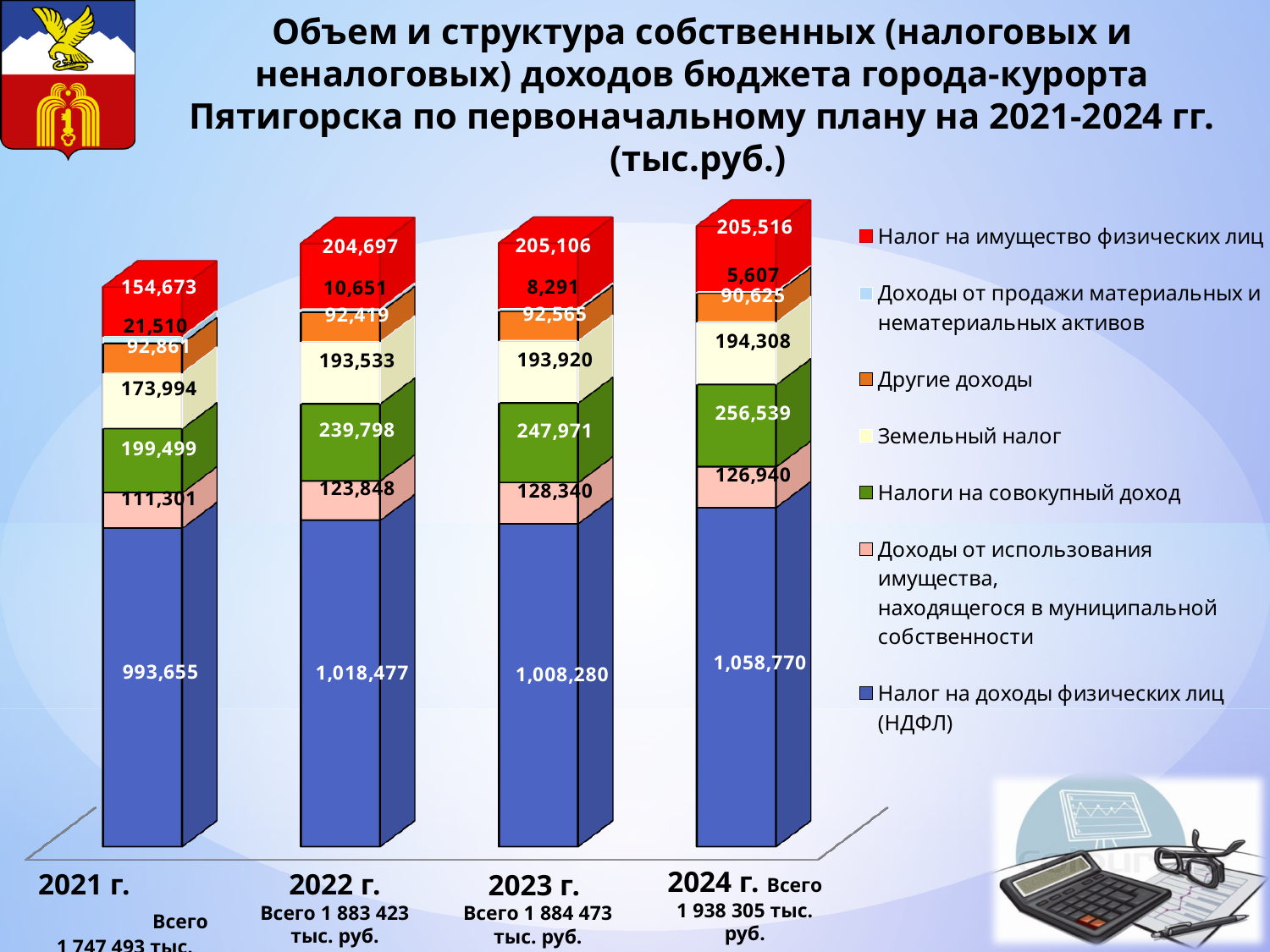
Which year has the larger value for Налоги на совокупный доход, 2022 г. or 2023 г.? 2023 г. In which year is the value for Доходы от продажи материальных и нематериальных активов the lowest? 2024 г. What is the value for Земельный налог in 2022 г.? 193,533 What is the value for Налог на доходы физических лиц (НДФЛ) in 2024 г.? 1,058,770 Do the values for Налоги на совокупный доход rise or fall from 2021 г. to 2024 г.? Rise What is the value for Налог на имущество физических лиц in 2021 г.? 154,673 What kind of chart is shown on the slide? Stacked bar chart In which year is the value for Налог на доходы физических лиц (НДФЛ) the highest? 2024 г. How many years are shown on the x axis of the chart? 4 How many series does the legend list? 7 By how much does Налог на доходы физических лиц (НДФЛ) in 2022 г. exceed the value in 2021 г.? 24,822 What is the total (Всего) of the stacked bar for 2024 г.? 1 938 305 тыс. руб.